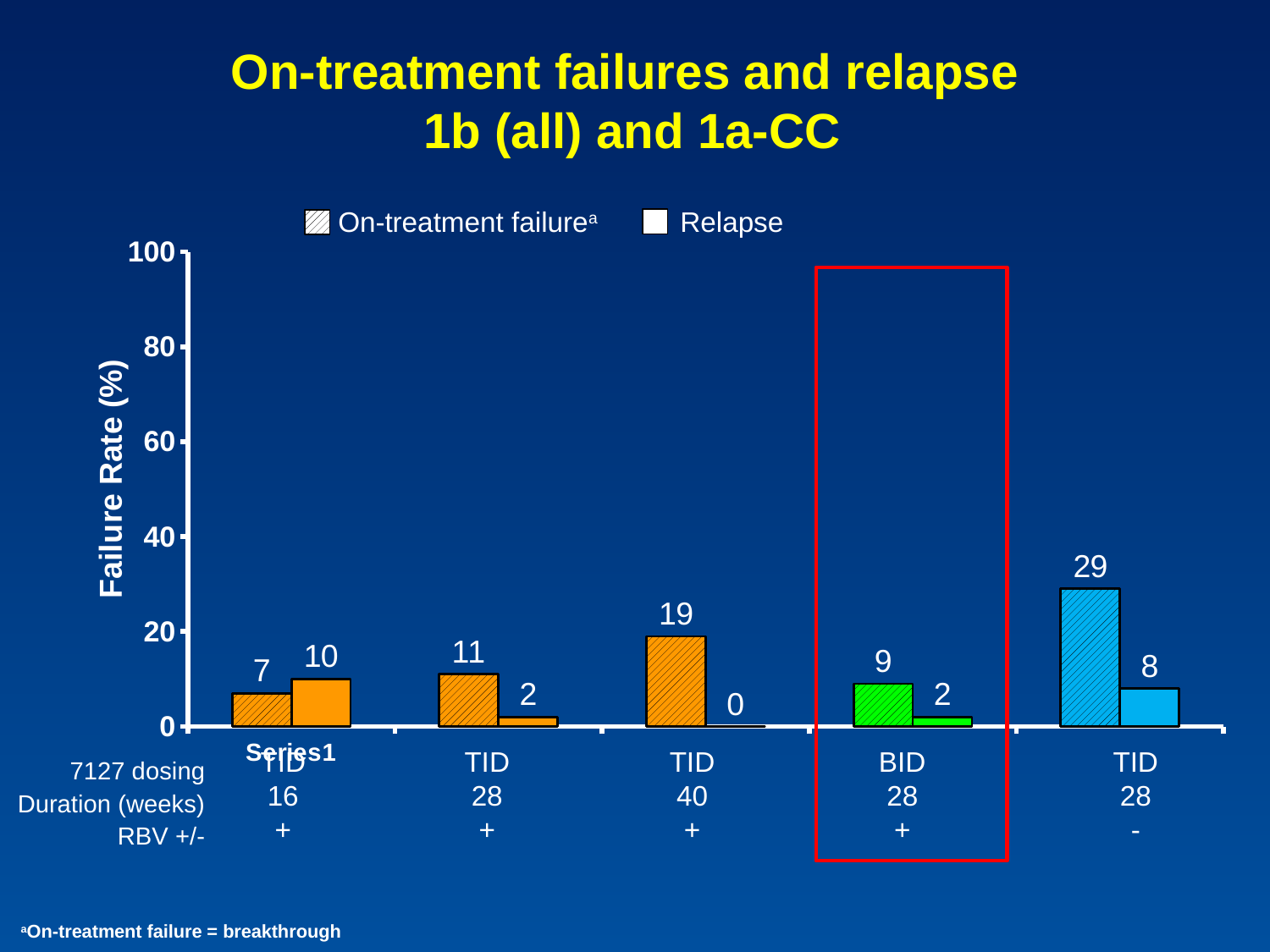
Which is larger for the TID 16-week RBV+ group: the on-treatment failure rate or the relapse rate? Relapse What is the relapse rate for the TID 28-week group without RBV (RBV -)? 8 How many dosing groups are shown on the x axis? 5 What kind of chart is shown on the slide? Bar chart Which group has the lowest relapse rate? TID 40 weeks, RBV + How many series does the legend list? 2 What is the relapse rate for the TID 16-week RBV+ group? 10 Which group has the highest on-treatment failure rate? TID 28 weeks, RBV - Is the on-treatment failure rate for the TID 28-week RBV- group greater or less than 20? greater What is the on-treatment failure rate for the TID 40-week RBV+ group? 19 What is the difference between the on-treatment failure rate and the relapse rate for the TID 28-week RBV- group? 21 What is the on-treatment failure rate for the BID 28-week RBV+ group (highlighted in the red box)? 9